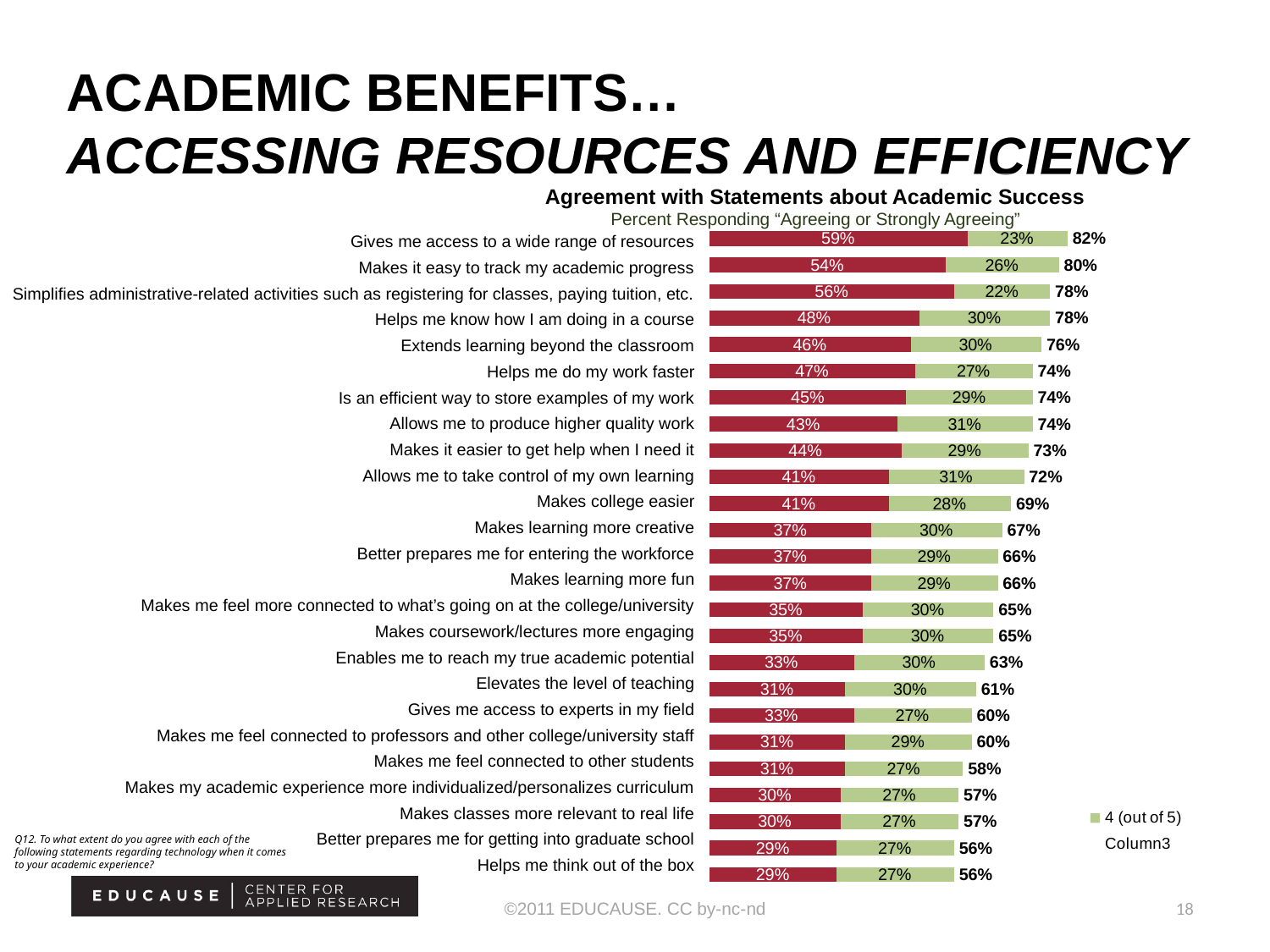
How many statements (categories) are plotted in the chart? 25 What kind of chart is shown on the slide? Stacked bar chart What is the value of the green segment for "Allows me to produce higher quality work"? 31% Which statement has the highest total percentage agreeing or strongly agreeing? Gives me access to a wide range of resources Which has the larger total: "Extends learning beyond the classroom" or "Helps me do my work faster"? Extends learning beyond the classroom What is the difference between the total for "Gives me access to a wide range of resources" and the total for "Helps me think out of the box"? 26 percentage points What is the value of the red segment for "Gives me access to a wide range of resources"? 59% Do the total percentages increase or decrease going from the top statement to the bottom statement? Decrease What is the total percentage shown for "Makes college easier"? 69% What is the title of the chart? Agreement with Statements about Academic Success How many entries does the chart's legend list? 2 For "Makes it easy to track my academic progress", how much larger is the red segment than the green segment? 28 percentage points